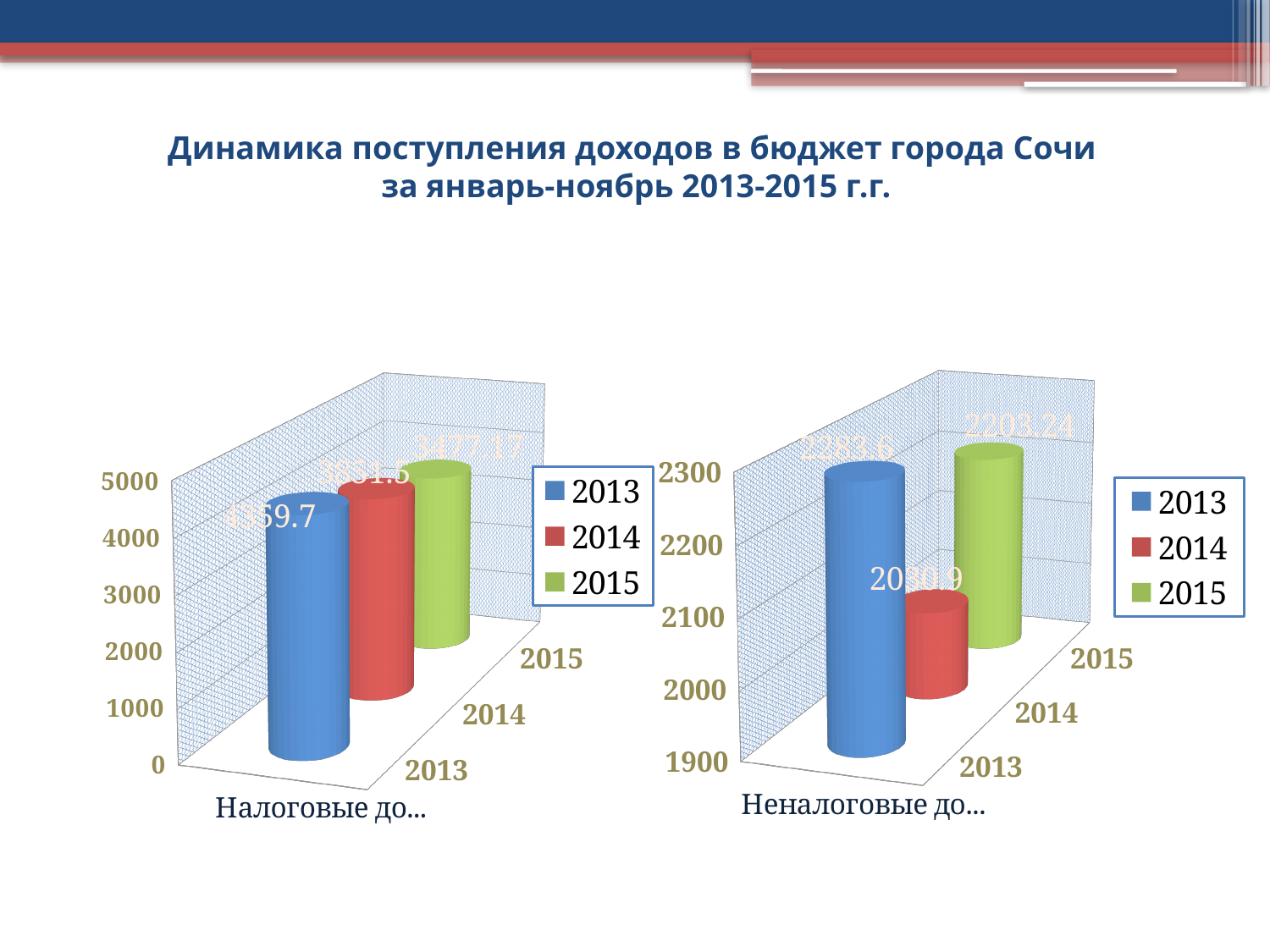
In the right chart (Неналоговые до...), what is the value for 2015? 2203.24 In the left chart (Налоговые до...), what is the difference between the 2013 and 2015 values? 882.53 In the left chart (Налоговые до...), what is the value for 2015? 3477.17 In the right chart (Неналоговые до...), is the value for 2014 greater or less than 2100? less In the right chart (Неналоговые до...), which year has the lowest value? 2014 In the left chart (Налоговые до...), which year has the lowest value? 2015 In the right chart (Неналоговые до...), what is the value for 2013? 2283.6 In the left chart (Налоговые до...), do the values rise or fall from 2013 to 2015? fall In the left chart (Налоговые до...), which year has the highest value? 2013 How many series does the legend of the right chart (Неналоговые до...) list? 3 What kind of chart is the left chart (Налоговые до...)? bar chart In the left chart (Налоговые до...), what is the value for 2013? 4359.7